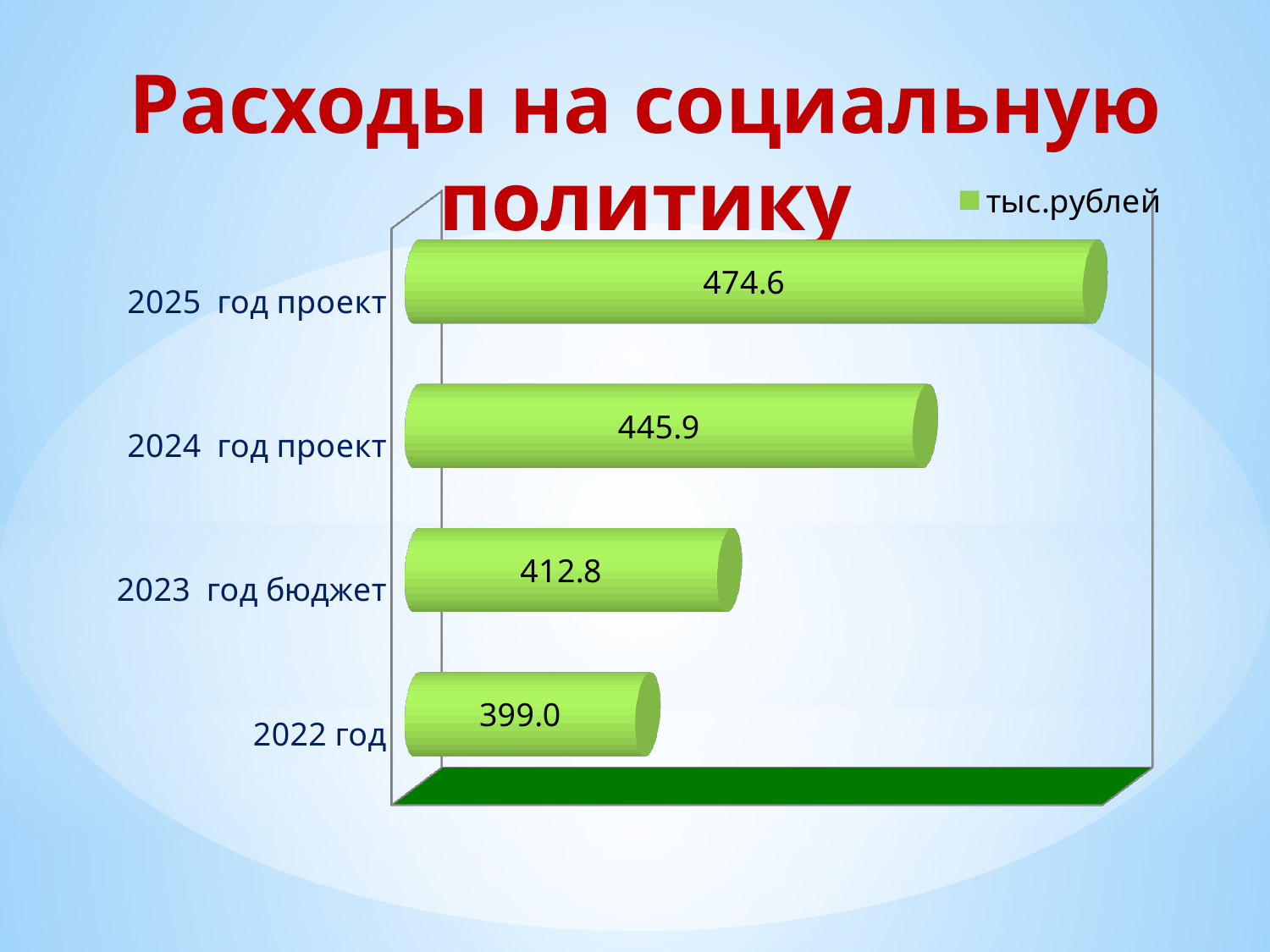
What is the value for 2025 год проект? 474.6 Which category has the lowest value? 2022 год Which category has the highest value? 2025 год проект What is the value for 2022 год? 399.0 What is the difference between the values for 2025 год проект and 2022 год? 75.6 How many categories are shown in the chart? 4 What series name does the legend show? тыс.рублей What is the value for 2024 год проект? 445.9 Which is larger, the value for 2023 год бюджет or the value for 2024 год проект? 2024 год проект What is the value for 2023 год бюджет? 412.8 What kind of chart is shown on the slide? bar chart What is the difference between the values for 2024 год проект and 2023 год бюджет? 33.1